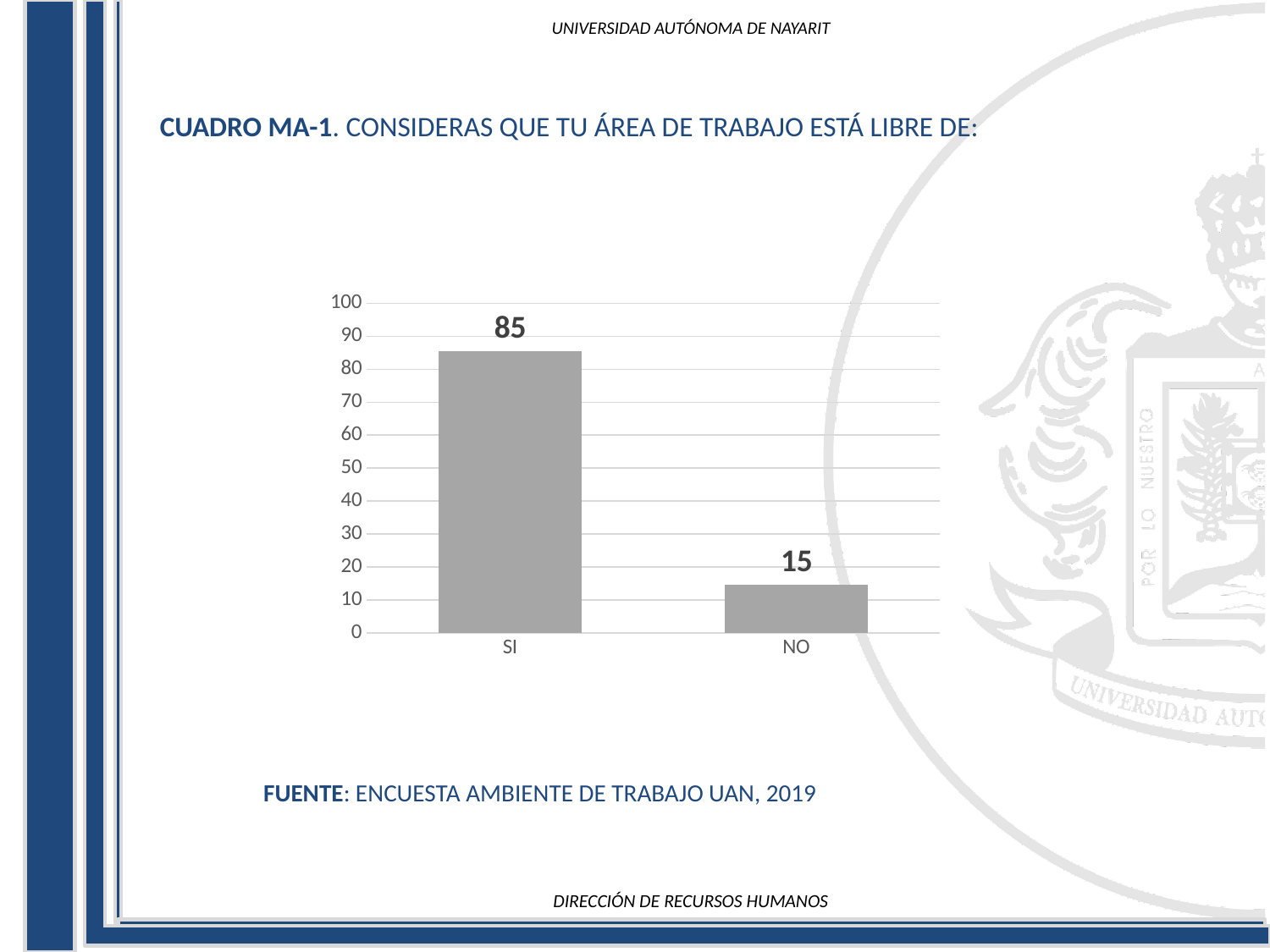
Which category has the highest value? SI What is the maximum value shown on the y axis? 100 What is the difference between the values for SI and NO? 70 What kind of chart is shown on the slide? bar chart Is the value for NO greater or less than 20? less Which is larger, the value for SI or the value for NO? SI Which category has the lowest value? NO What is the value for SI? 85 Is the value for SI greater or less than 80? greater What is the total of the values for SI and NO? 100 What is the value for NO? 15 How many categories are shown on the x axis? 2